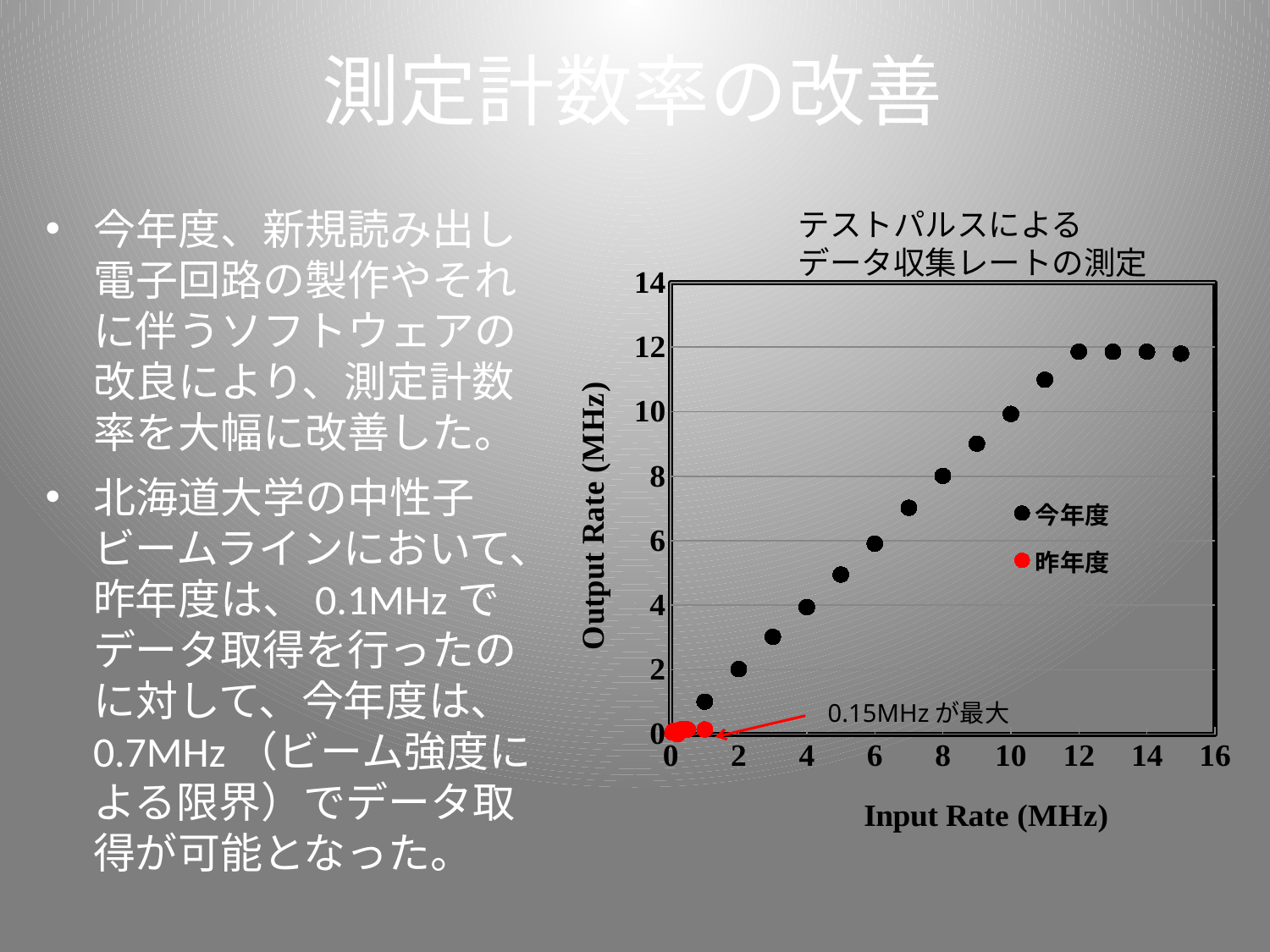
Is the 今年度 output rate at an input rate of 2 MHz greater or less than 4? less What kind of chart is shown on the slide? scatter chart How many series does the chart legend list? 2 According to the annotation on the chart, what is the maximum rate for 昨年度? 0.15MHz Is the 今年度 output rate at an input rate of 4 MHz greater or less than 6? less Is the 今年度 output rate at an input rate of 8 MHz greater or less than 6? greater What are the two series named in the chart legend? 今年度, 昨年度 What is the title of the chart? テストパルスによるデータ収集レートの測定 Does the 今年度 output rate rise or fall as the input rate increases from 0 to 10 MHz? rise Which series reaches higher output rates, 今年度 or 昨年度? 今年度